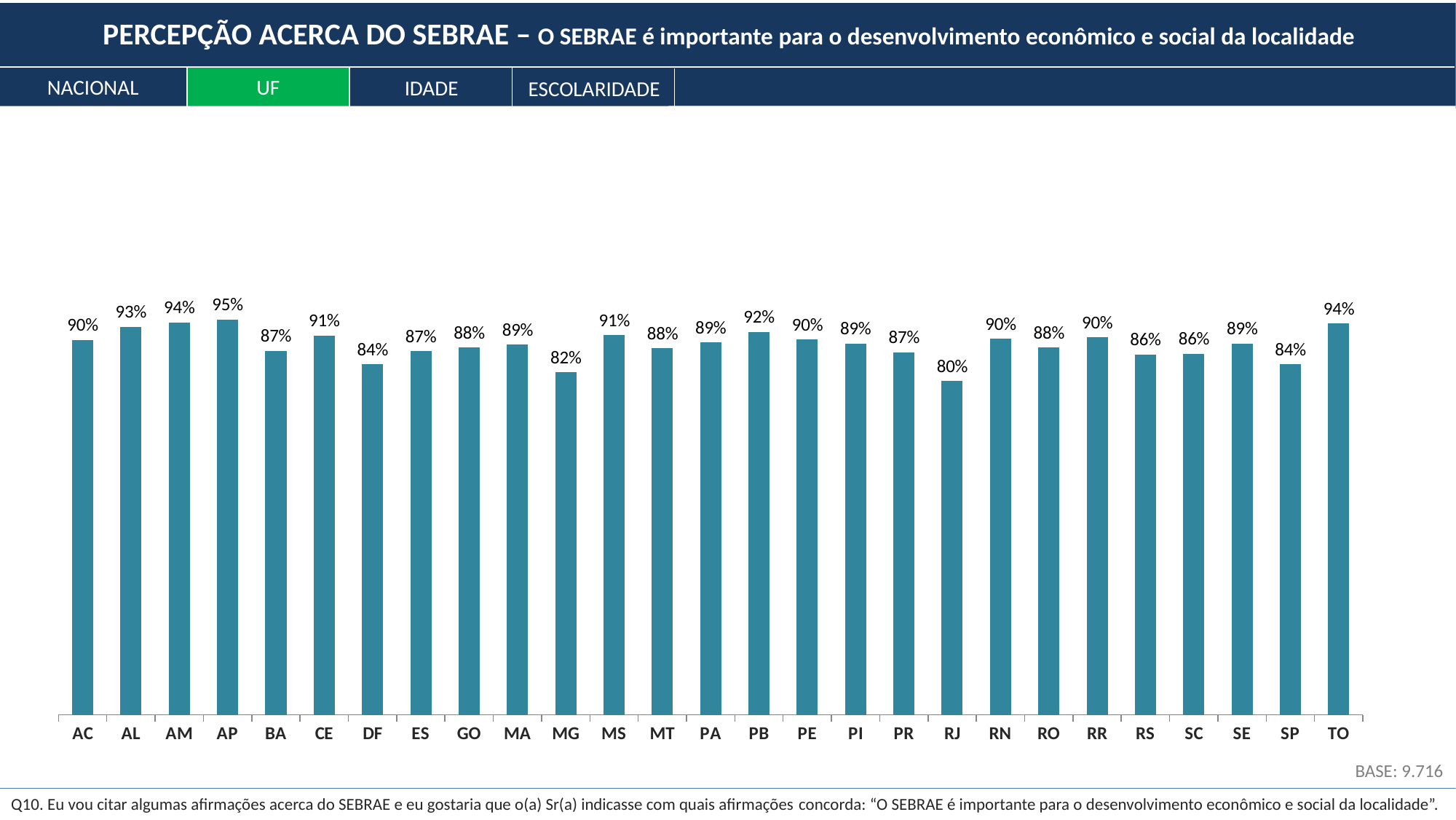
Which UF has the highest value? AP Which is larger, the value for AL or the value for BA? AL What is the value for AP? 95% What is the difference between the values for TO and SP? 10% What is the value for MG? 82% Which UF has the lowest value? RJ What is the value for RJ? 80% What is the base (BASE) shown on the slide? 9.716 What is the value for PB? 92% How many UFs are shown on the x axis? 27 What kind of chart is shown on the slide? Bar chart What is the difference between the values for AP and RJ? 15%